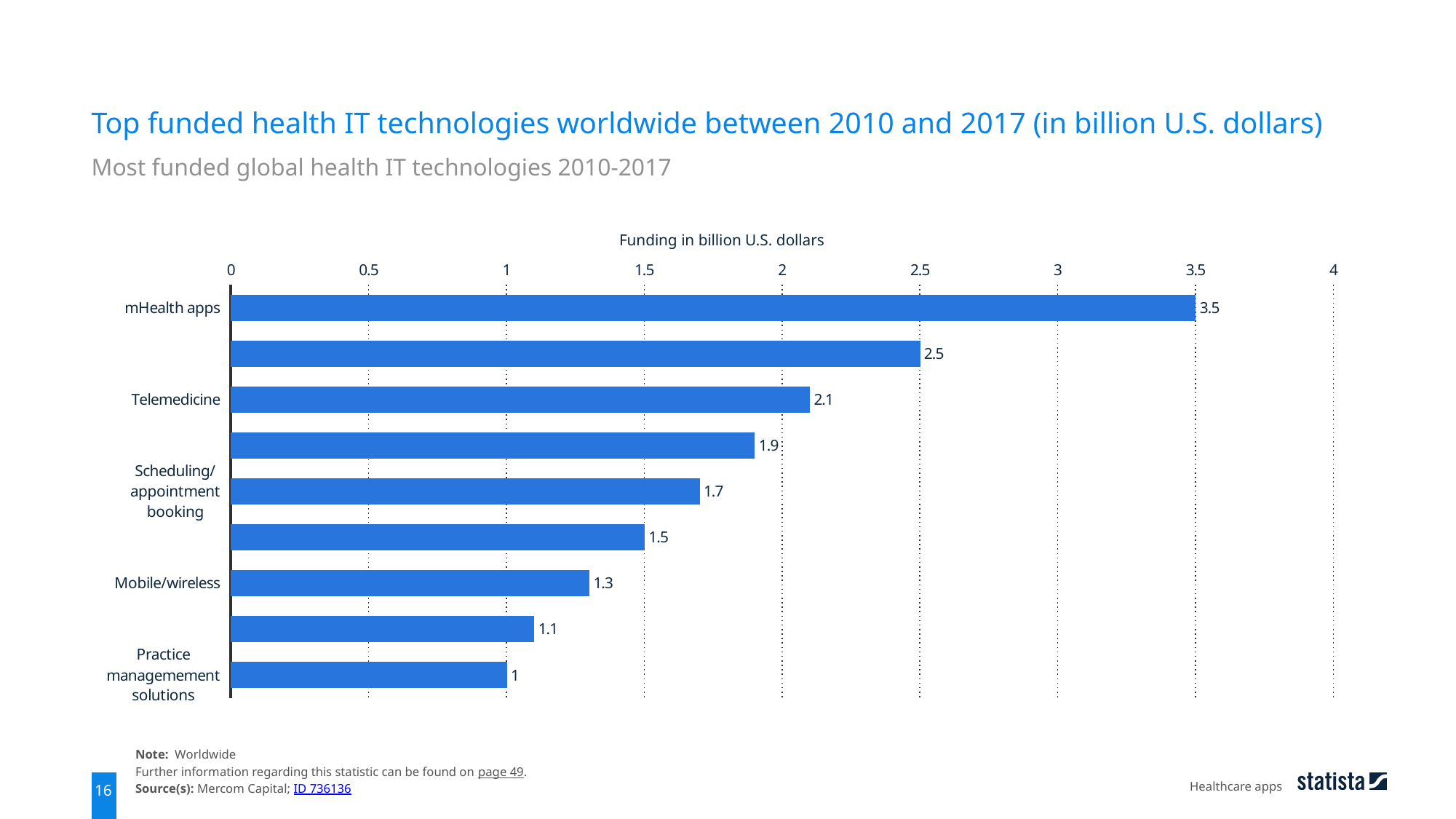
What is the funding value for Scheduling/appointment booking? 1.7 How many bars are plotted in the chart? 9 What is the funding value for Mobile/wireless? 1.3 Which received more funding, Mobile/wireless or Scheduling/appointment booking? Scheduling/appointment booking What is the funding value for Telemedicine? 2.1 Which labeled technology received the lowest funding? Practice management solutions What type of chart is shown on the slide? Bar chart What is the funding value for Practice management solutions? 1 Which technology received the highest funding? mHealth apps What is the difference in funding between mHealth apps and Telemedicine? 1.4 What is the funding value for mHealth apps? 3.5 What is the label of the value axis? Funding in billion U.S. dollars